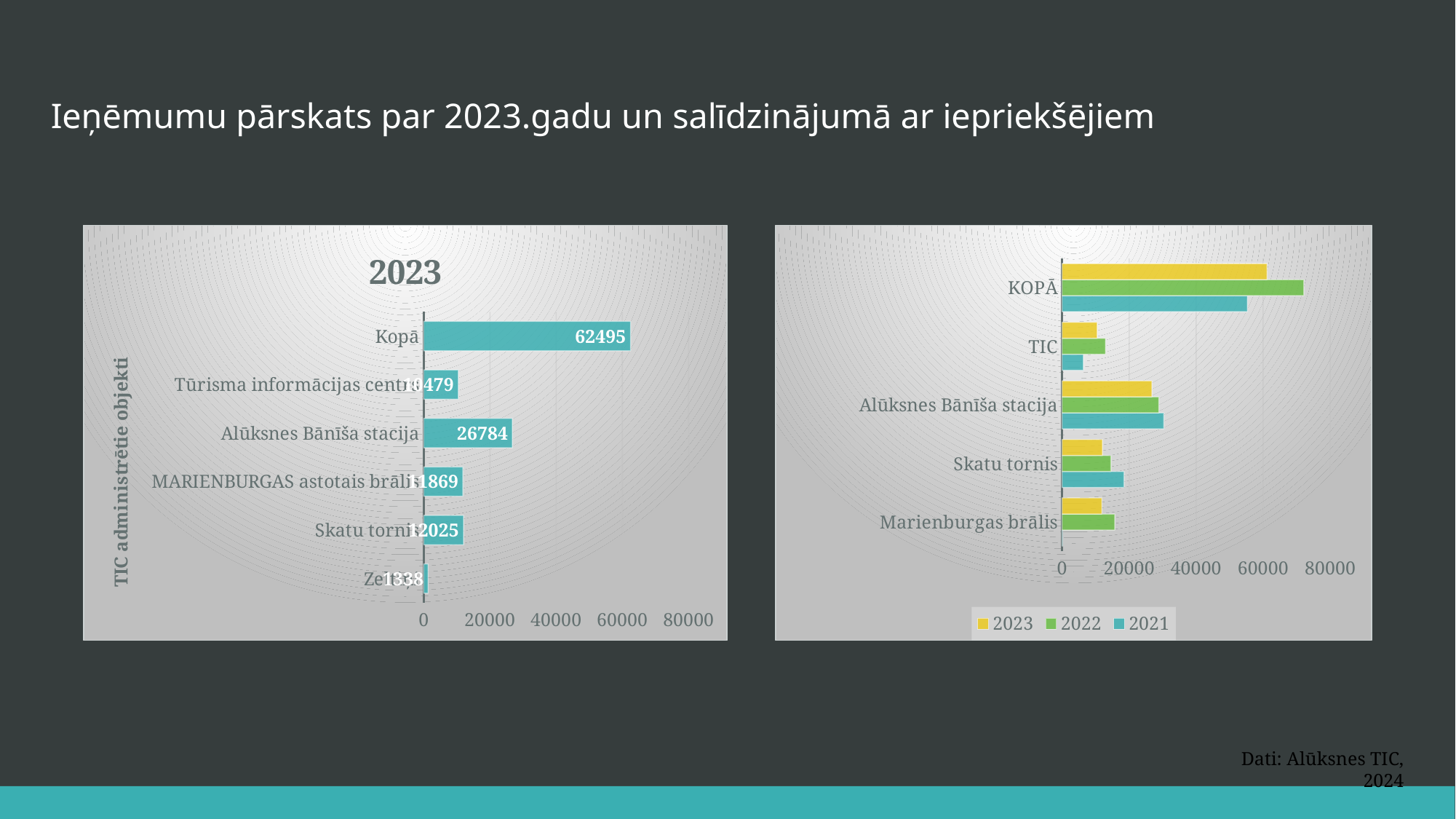
In the left chart titled "2023", what is the value for Skatu tornis? 12025 In the left chart titled "2023", what is the value for Kopā? 62495 In the right chart, which year has the highest value for KOPĀ? 2022 In the left chart titled "2023", what is the value for Alūksnes Bānīša stacija? 26784 What kind of chart is the left chart titled "2023"? bar chart How many series does the legend of the right chart list? 3 In the left chart titled "2023", what is the difference between the values for Alūksnes Bānīša stacija and Skatu tornis? 14759 In the right chart, is the 2022 value for KOPĀ greater or less than 60000? greater In the left chart titled "2023", which is larger: the value for Skatu tornis or for MARIENBURGAS astotais brālis? Skatu tornis In the left chart titled "2023", excluding the Kopā total, which category has the highest value? Alūksnes Bānīša stacija How many categories are shown on the right chart? 5 What are the legend entries of the right chart? 2023, 2022, 2021